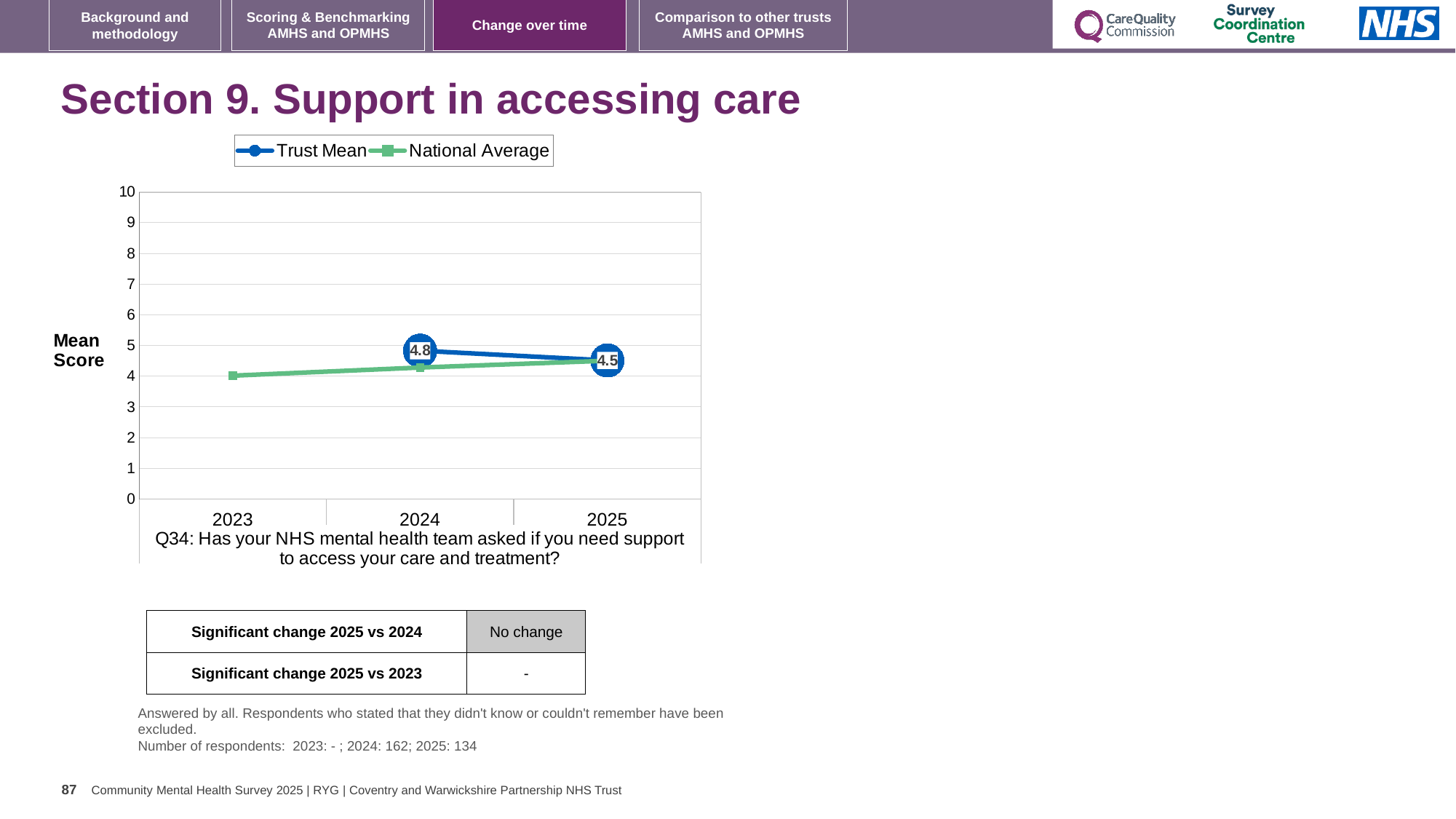
Is the National Average value for 2023 greater or less than 5? less Which year has the higher Trust Mean score, 2024 or 2025? 2024 What is the Trust Mean score for 2024? 4.8 What is the label on the y axis of the chart? Mean Score Does the National Average line rise or fall from 2023 to 2025? rise What is the Trust Mean score for 2025? 4.5 Does the Trust Mean line rise or fall from 2024 to 2025? fall By how much did the Trust Mean score change from 2024 to 2025? 0.3 How many series does the legend list? 2 Is the National Average value for 2024 greater or less than 3? greater What kind of chart is shown on the slide? line chart How many years are shown on the x axis? 3